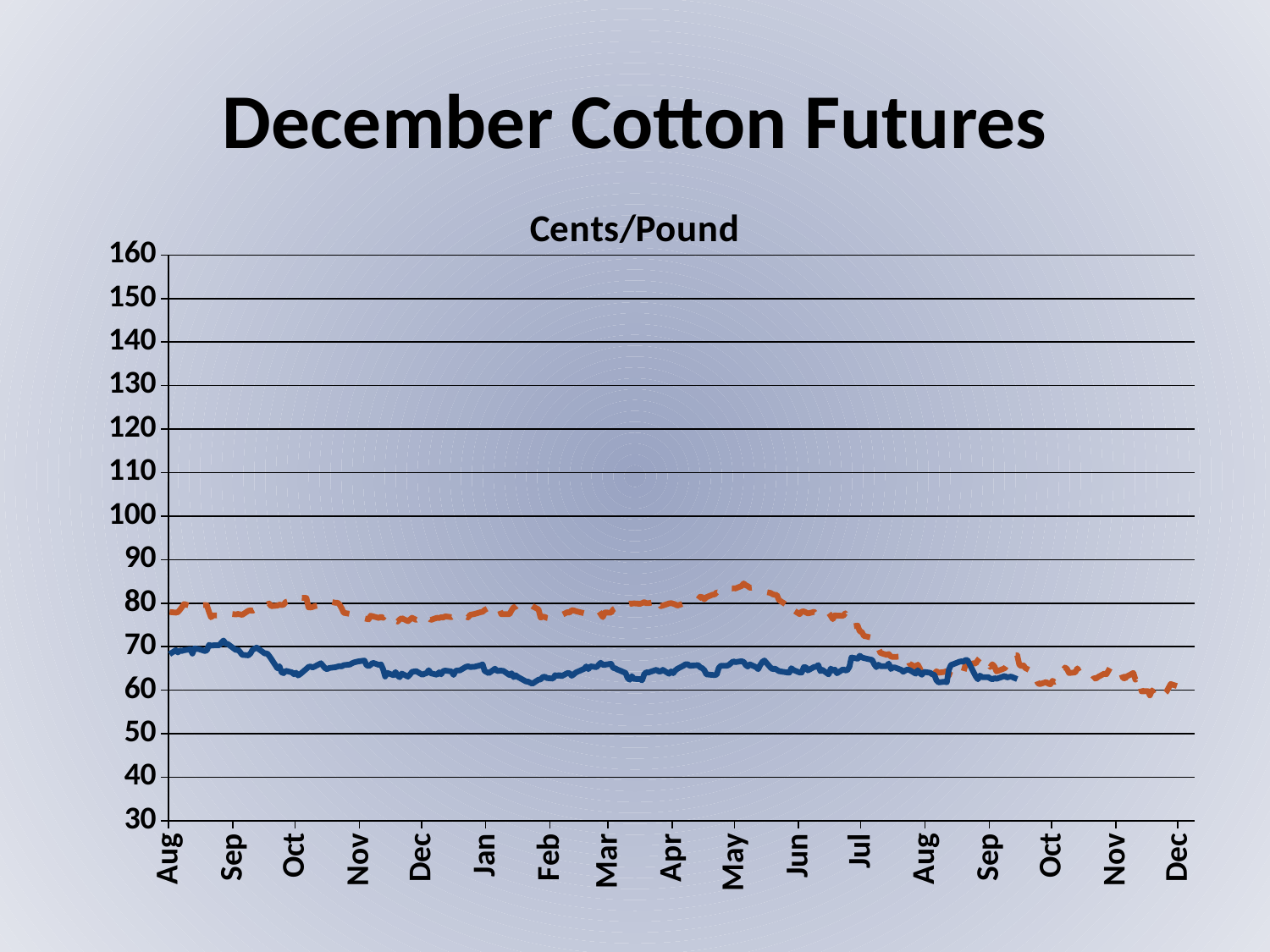
In May, which line is higher, the dashed orange line or the solid blue line? the dashed orange line Is the value of the dashed orange line at the second Nov label greater or less than 70? less What is the highest value shown on the y axis? 160 Is the value of the dashed orange line at the first Aug label greater or less than 70? greater How many lines are plotted on the chart? 2 How many month labels are shown along the x axis? 17 Around which month does the dashed orange line reach its highest value? May Is the value of the dashed orange line in May greater or less than 80? greater What is the title shown above the chart's plot area? Cents/Pound What kind of chart is shown on the slide? line chart Does the dashed orange line rise or fall between Jul and Dec? fall